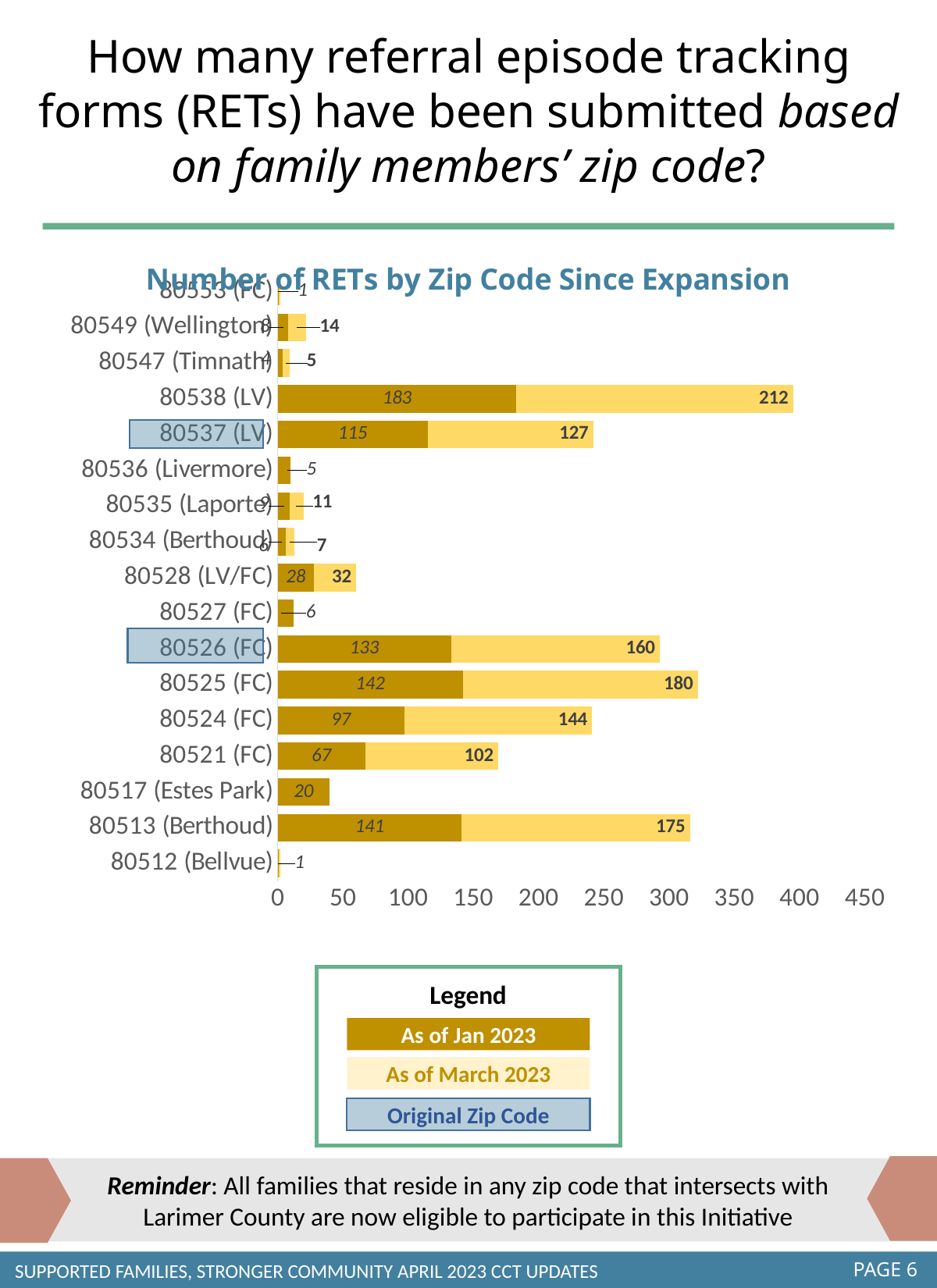
Which zip codes are highlighted as Original Zip Code on the chart? 80537 (LV) and 80526 (FC) What is the As of Jan 2023 value for 80538 (LV)? 183 Which has the larger As of Jan 2023 value, 80524 (FC) or 80521 (FC)? 80524 (FC) Which zip code has the highest As of March 2023 value? 80538 (LV) What is the As of March 2023 value for 80528 (LV/FC)? 32 What is the total of the stacked bar for 80526 (FC)? 293 What is the difference between the As of March 2023 and As of Jan 2023 values for 80538 (LV)? 29 Is the total stacked bar for 80538 (LV) greater or less than 350? greater What kind of chart is shown on the slide? Stacked bar chart How many zip code categories are shown on the chart? 17 What is the As of March 2023 value for 80525 (FC)? 180 What is the As of Jan 2023 value for 80517 (Estes Park)? 20